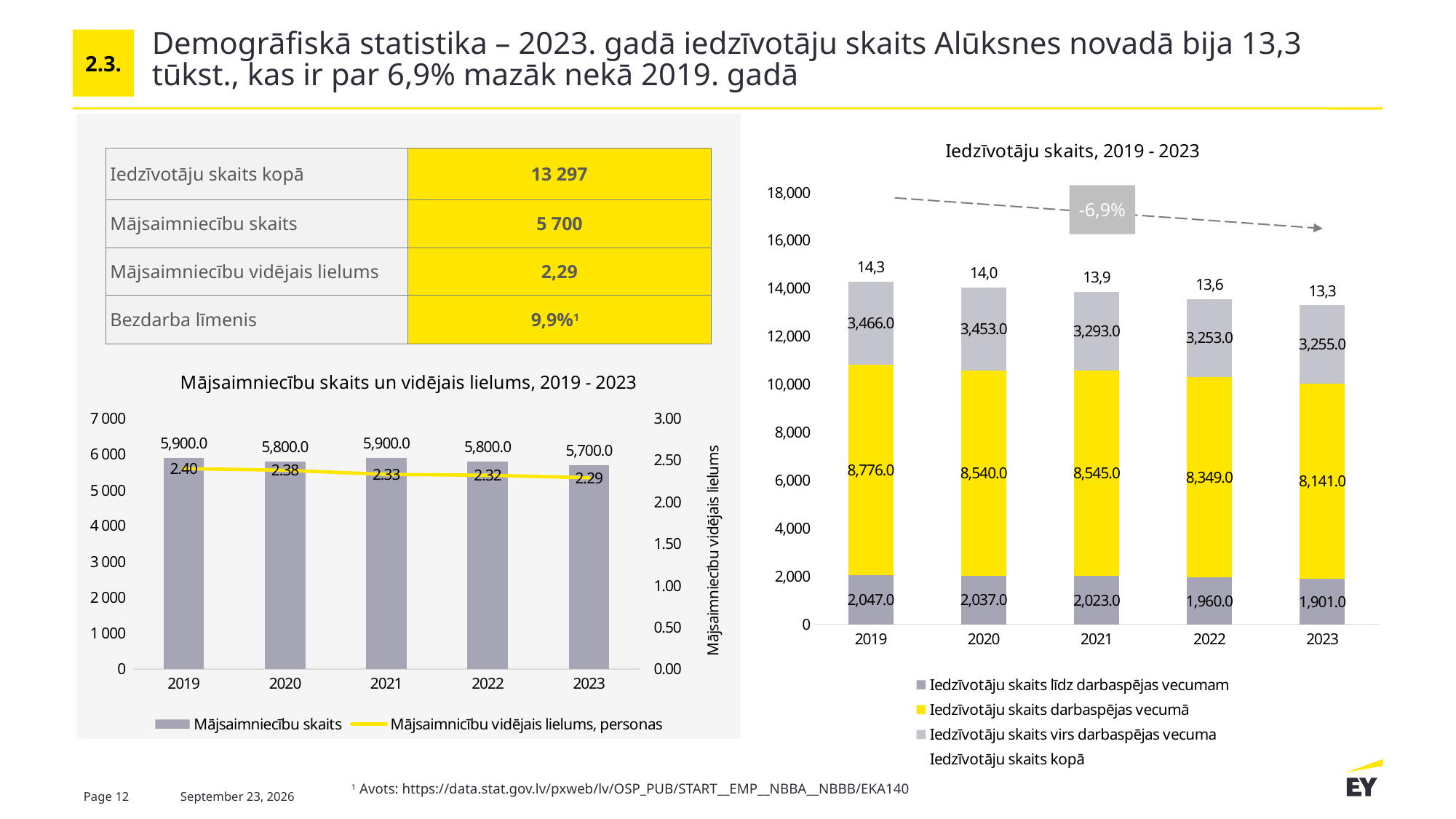
In the chart 'Iedzīvotāju skaits, 2019 - 2023', what is the value for 'Iedzīvotāju skaits līdz darbaspējas vecumam' in 2023? 1,901.0 In the chart 'Iedzīvotāju skaits, 2019 - 2023', which year has the lowest value for 'Iedzīvotāju skaits darbaspējas vecumā'? 2023 In the chart 'Iedzīvotāju skaits, 2019 - 2023', what is the difference between the 'Iedzīvotāju skaits virs darbaspējas vecuma' values for 2019 and 2023? 211.0 In the chart 'Mājsaimniecību skaits un vidējais lielums, 2019 - 2023', what is the value of 'Mājsaimniecību skaits' in 2023? 5,700.0 In the chart 'Mājsaimniecību skaits un vidējais lielums, 2019 - 2023', how many years are shown on the x axis? 5 In the chart 'Mājsaimniecību skaits un vidējais lielums, 2019 - 2023', what is the value of 'Mājsaimnicību vidējais lielums, personas' in 2020? 2.38 In the chart 'Iedzīvotāju skaits, 2019 - 2023', how many series does the legend list? 4 In the chart 'Iedzīvotāju skaits, 2019 - 2023', what is the value for 'Iedzīvotāju skaits darbaspējas vecumā' in 2019? 8,776.0 In the chart 'Iedzīvotāju skaits, 2019 - 2023', what percentage change is shown in the grey box above the bars? -6,9% In the chart 'Iedzīvotāju skaits, 2019 - 2023', what is the total population label shown above the 2021 bar? 13,9 In the chart 'Mājsaimniecību skaits un vidējais lielums, 2019 - 2023', is the 'Mājsaimniecību skaits' value for 2021 larger or smaller than the value for 2022? larger In the chart 'Mājsaimniecību skaits un vidējais lielums, 2019 - 2023', does the average household size rise or fall from 2019 to 2023? fall